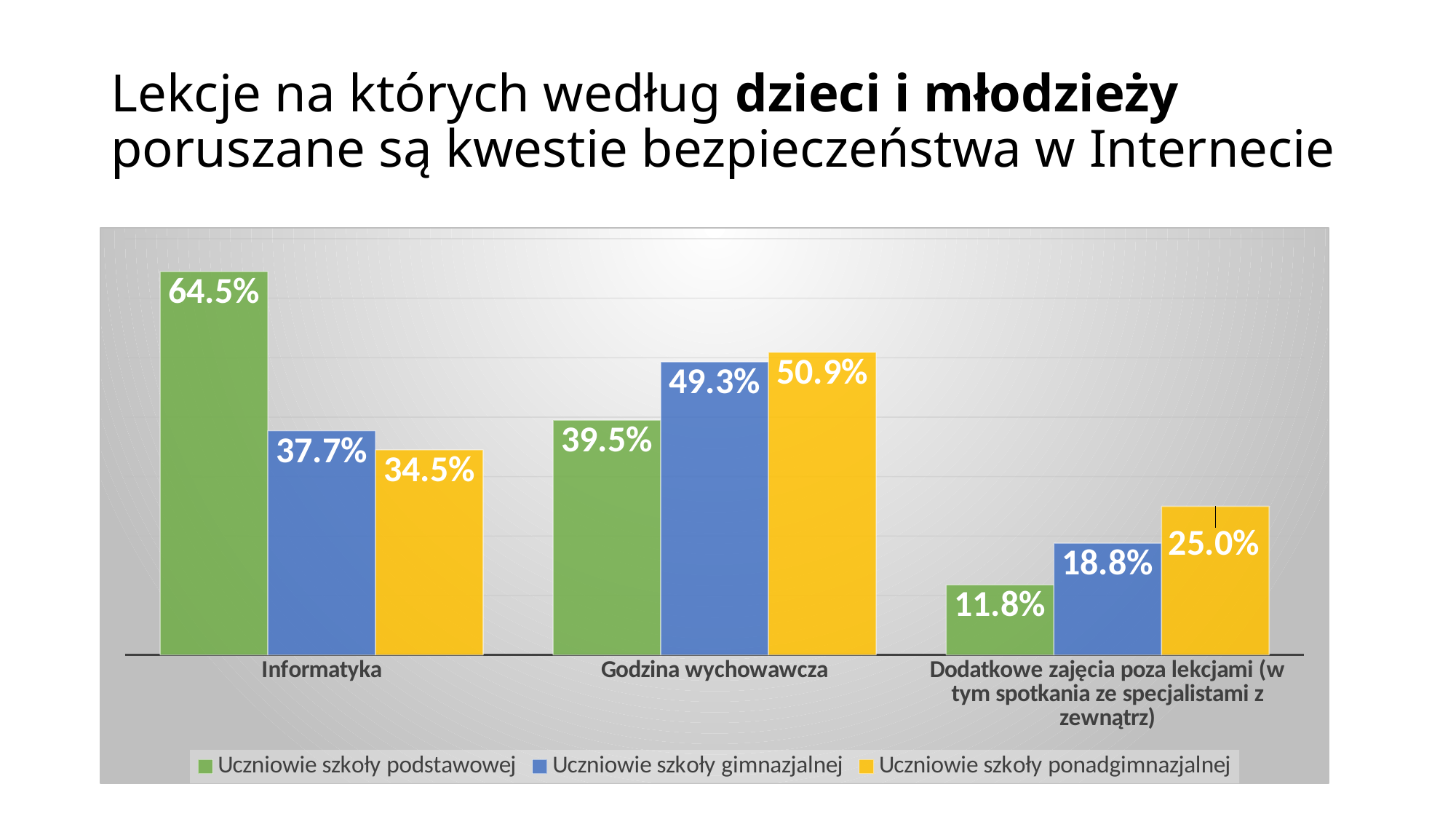
What is the difference between Uczniowie szkoły podstawowej and Uczniowie szkoły gimnazjalnej in the Informatyka category? 26.8% What kind of chart is shown on the slide? Bar chart What is the difference between Uczniowie szkoły ponadgimnazjalnej and Uczniowie szkoły podstawowej in the Dodatkowe zajęcia poza lekcjami category? 13.2% What is the value for Uczniowie szkoły gimnazjalnej in the Dodatkowe zajęcia poza lekcjami category? 18.8% Which colour represents Uczniowie szkoły ponadgimnazjalnej in the legend? Yellow How many categories are shown on the x axis? 3 Which category has the highest value for Uczniowie szkoły podstawowej? Informatyka What is the value for Uczniowie szkoły ponadgimnazjalnej in the Godzina wychowawcza category? 50.9% Which category has the lowest value for Uczniowie szkoły ponadgimnazjalnej? Dodatkowe zajęcia poza lekcjami (w tym spotkania ze specjalistami z zewnątrz) How many series does the legend list? 3 What is the value for Uczniowie szkoły podstawowej in the Informatyka category? 64.5% Which is larger in the Godzina wychowawcza category: Uczniowie szkoły podstawowej or Uczniowie szkoły gimnazjalnej? Uczniowie szkoły gimnazjalnej